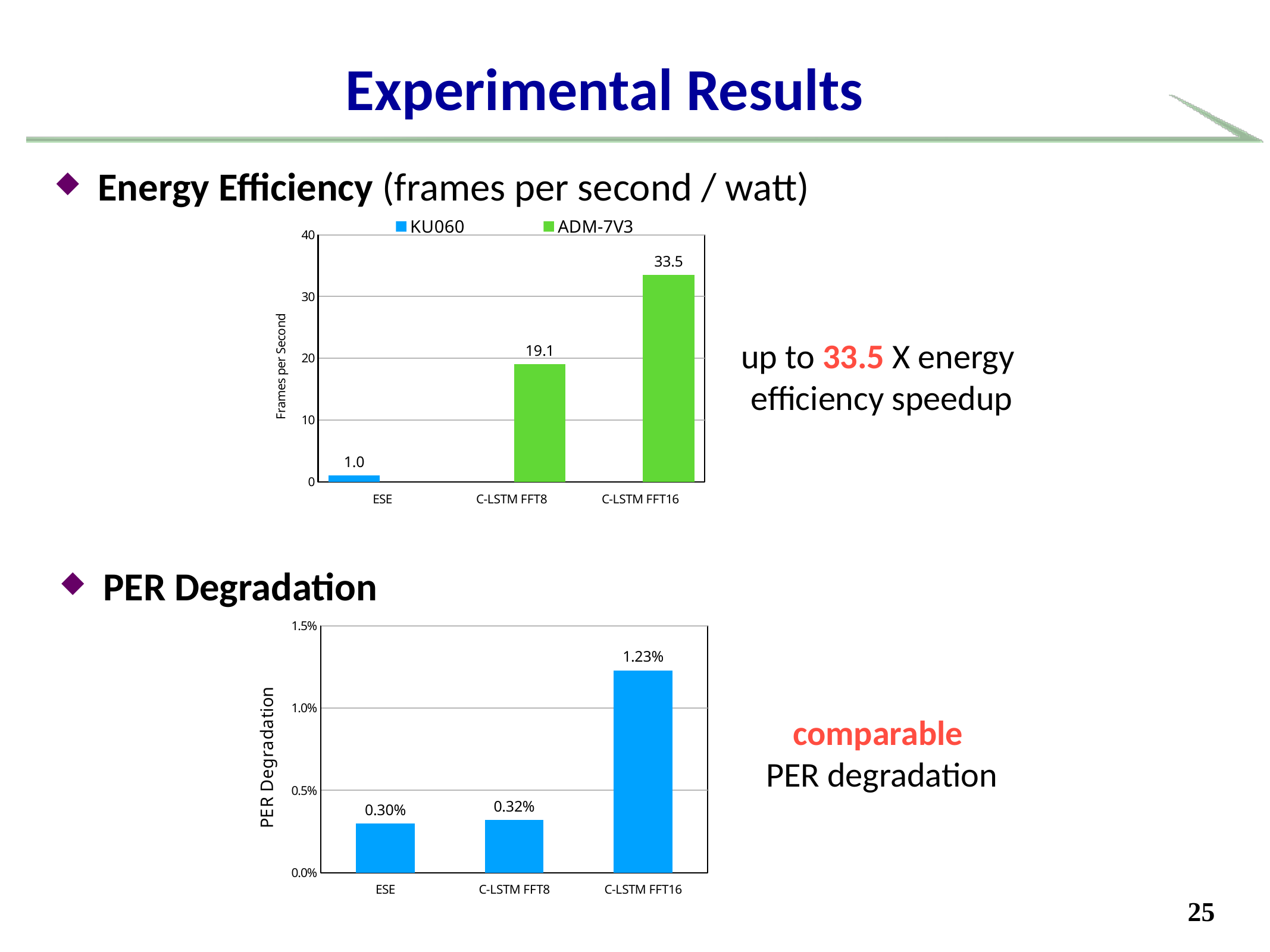
In the PER Degradation chart, which category has the lowest value? ESE In the Energy Efficiency chart, what is the value for ESE? 1.0 In the PER Degradation chart, what is the difference between the values for C-LSTM FFT16 and ESE? 0.93% In the Energy Efficiency chart, which category has the highest value? C-LSTM FFT16 In the PER Degradation chart, what is the value for ESE? 0.30% In the Energy Efficiency chart, what is the value for C-LSTM FFT16? 33.5 In the PER Degradation chart, how many categories are shown on the x axis? 3 In the PER Degradation chart, what is the value for C-LSTM FFT16? 1.23% In the Energy Efficiency chart, how many series does the legend list? 2 In the Energy Efficiency chart, what is the value for C-LSTM FFT8? 19.1 In the Energy Efficiency chart, what is the difference between the values for C-LSTM FFT16 and C-LSTM FFT8? 14.4 In the Energy Efficiency chart, which series is shown in green? ADM-7V3